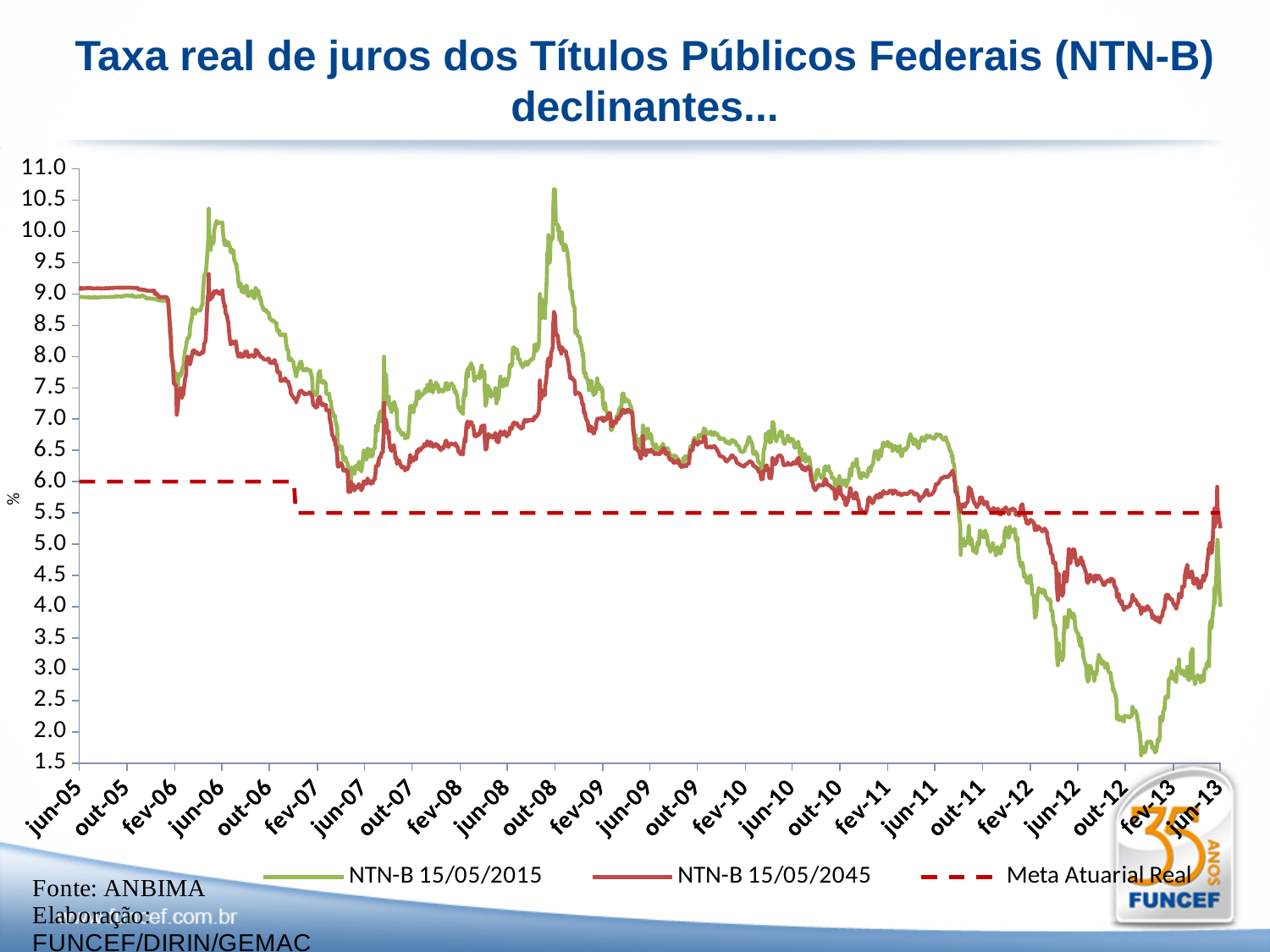
Is the peak value of the NTN-B 15/05/2015 line around out-08 greater or less than 10.0? greater At the right end of the chart (jun-13), which line is higher: NTN-B 15/05/2015 or NTN-B 15/05/2045? NTN-B 15/05/2045 What is the value of the Meta Atuarial Real line at jun-13? 5.5 What kind of chart is shown on the slide? line chart Which series reaches the highest value on the chart? NTN-B 15/05/2015 What is the value of the Meta Atuarial Real line at jun-05? 6.0 How many series does the legend list? 3 Do the NTN-B lines generally rise or fall from jun-05 to jun-13? fall By how much does the Meta Atuarial Real line drop when it steps down in early 2007? 0.5 Is the value of the NTN-B 15/05/2045 line around out-12 greater or less than 4.5? less What is the title of the chart? Taxa real de juros dos Títulos Públicos Federais (NTN-B) declinantes... Is the lowest value of the NTN-B 15/05/2015 line in early 2013 greater or less than 2.0? less